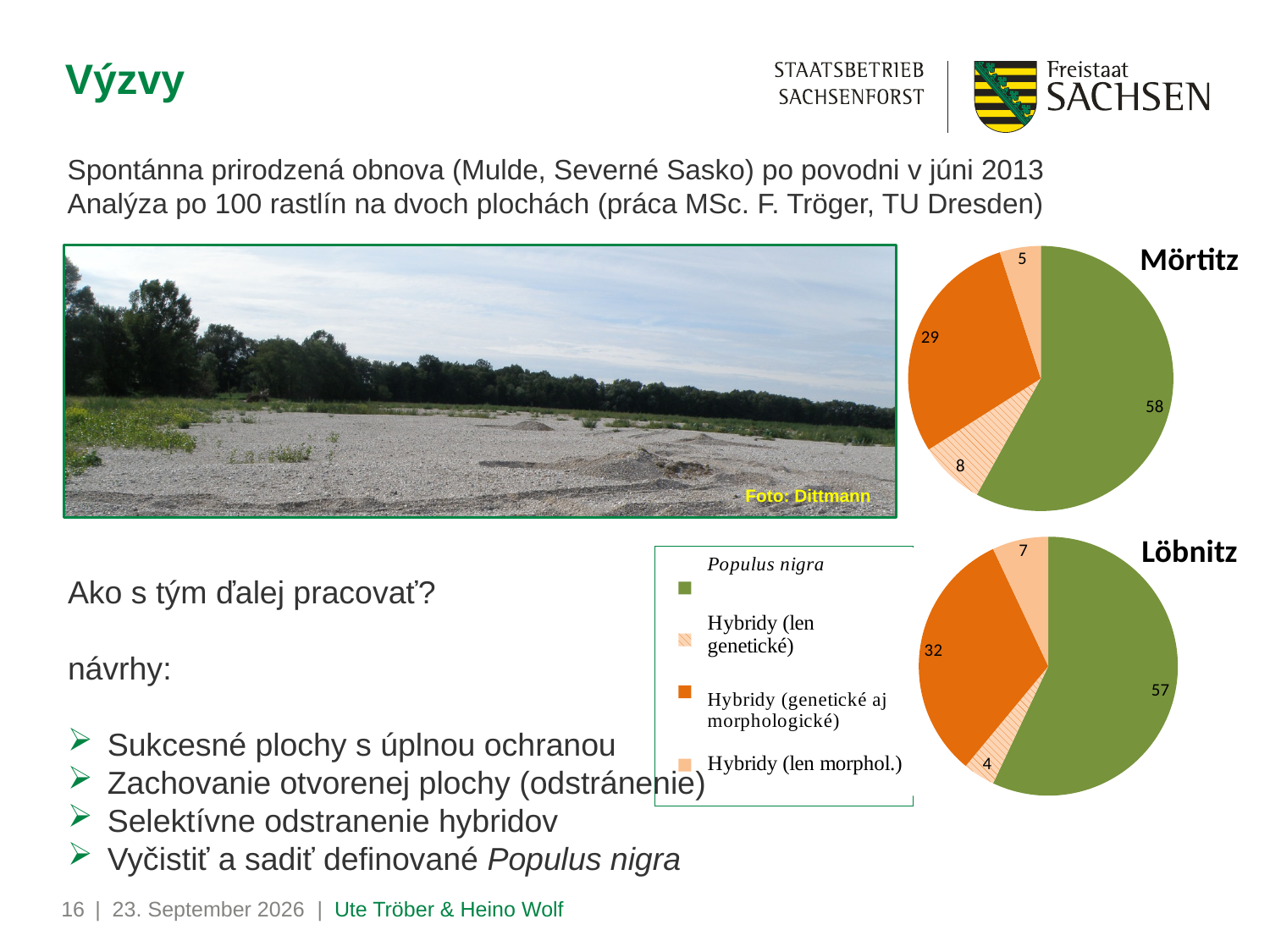
What is the difference between the Populus nigra values in the Mörtitz and Löbnitz pie charts? 1 How many slices does the Löbnitz pie chart have? 4 In the Löbnitz pie chart, what is the value for Hybridy (len genetické)? 4 In the Mörtitz pie chart, what is the value for Populus nigra? 58 In the Mörtitz pie chart, which category has the largest slice? Populus nigra In the Mörtitz pie chart, what is the difference between Hybridy (genetické aj morphologické) and Hybridy (len genetické)? 21 In the Mörtitz pie chart, what is the value for Hybridy (len morphol.)? 5 What type of chart is used for Mörtitz and Löbnitz? Pie chart In the Löbnitz pie chart, what is the value for Hybridy (genetické aj morphologické)? 32 Which is larger in the Löbnitz pie chart: Hybridy (len morphol.) or Hybridy (len genetické)? Hybridy (len morphol.) What share of the Mörtitz pie does Populus nigra represent? 58% In the Löbnitz pie chart, which category has the smallest slice? Hybridy (len genetické)